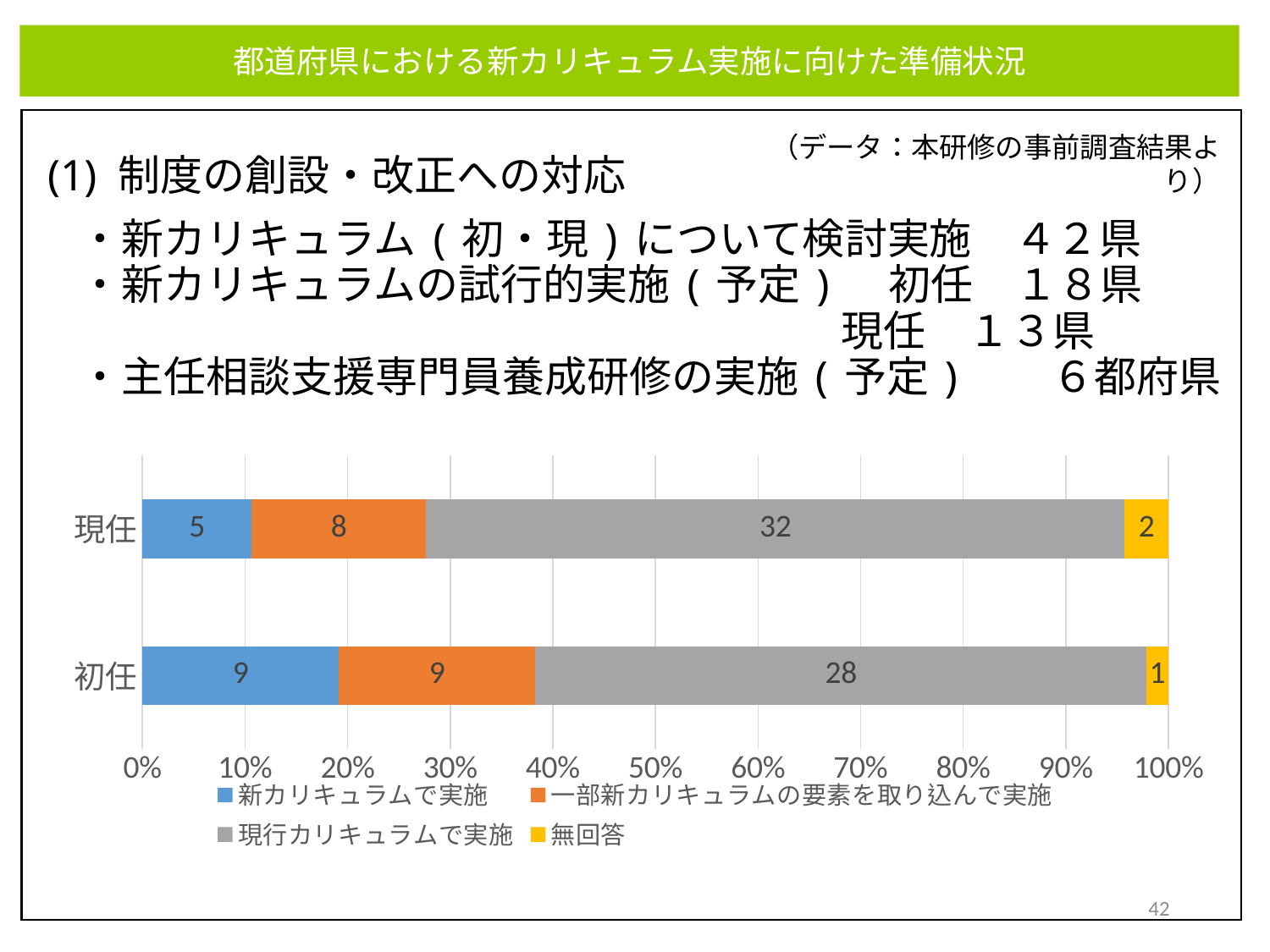
Which colour represents 無回答 in the chart? yellow What type of chart is shown on the slide? stacked bar chart How many categories are plotted on the chart? 2 What is the total of the stacked bar for 現任? 47 Which series has the highest value for 現任? 現行カリキュラムで実施 Which category has the larger value for 新カリキュラムで実施, 現任 or 初任? 初任 What is the difference between the 現行カリキュラムで実施 values for 現任 and 初任? 4 What is the value of 一部新カリキュラムの要素を取り込んで実施 for 初任? 9 What is the value of 無回答 for 現任? 2 What is the value of 現行カリキュラムで実施 for 初任? 28 What is the value of 新カリキュラムで実施 for 現任? 5 How many series does the legend list? 4